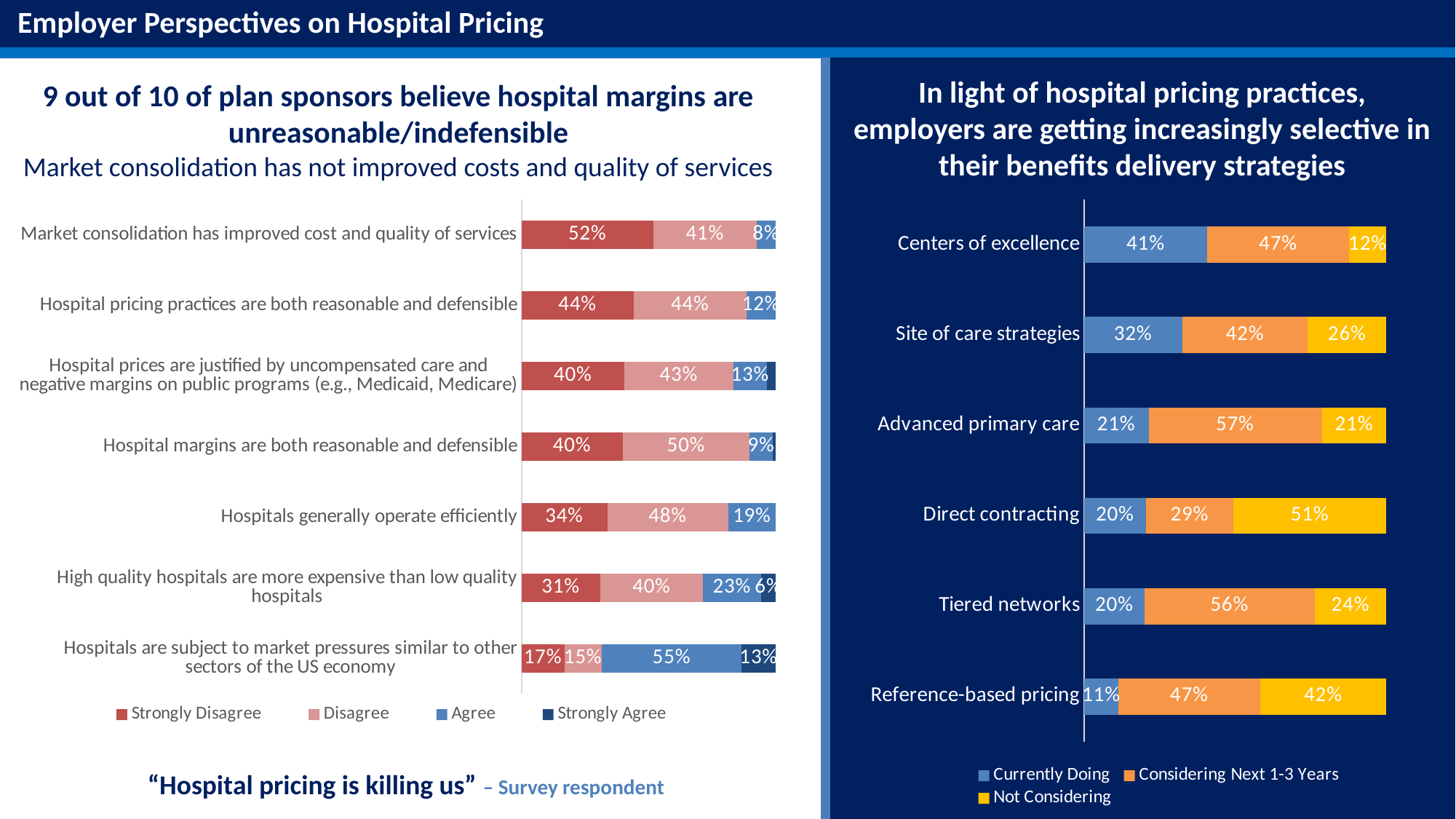
In the left chart, what percentage of respondents strongly disagree that market consolidation has improved cost and quality of services? 52% In the left chart, what percentage of respondents agree that hospitals are subject to market pressures similar to other sectors of the US economy? 55% What kind of chart is the right chart? Stacked bar chart What are the three legend entries of the right chart? Currently Doing, Considering Next 1-3 Years, Not Considering In the left chart, what is the difference between the Disagree and Strongly Disagree percentages for 'Hospital margins are both reasonable and defensible'? 10 percentage points In the left chart, which statement has the highest Strongly Disagree percentage? Market consolidation has improved cost and quality of services How many benefits delivery strategies are shown in the right chart? 6 In the right chart, what is the difference between the Considering Next 1-3 Years and Currently Doing percentages for advanced primary care? 36 percentage points In the right chart, which has a larger Currently Doing percentage: site of care strategies or tiered networks? Site of care strategies How many series does the legend of the left chart list? 4 In the right chart, what percentage of employers are currently doing centers of excellence? 41% In the right chart, which strategy has the highest Not Considering percentage? Direct contracting